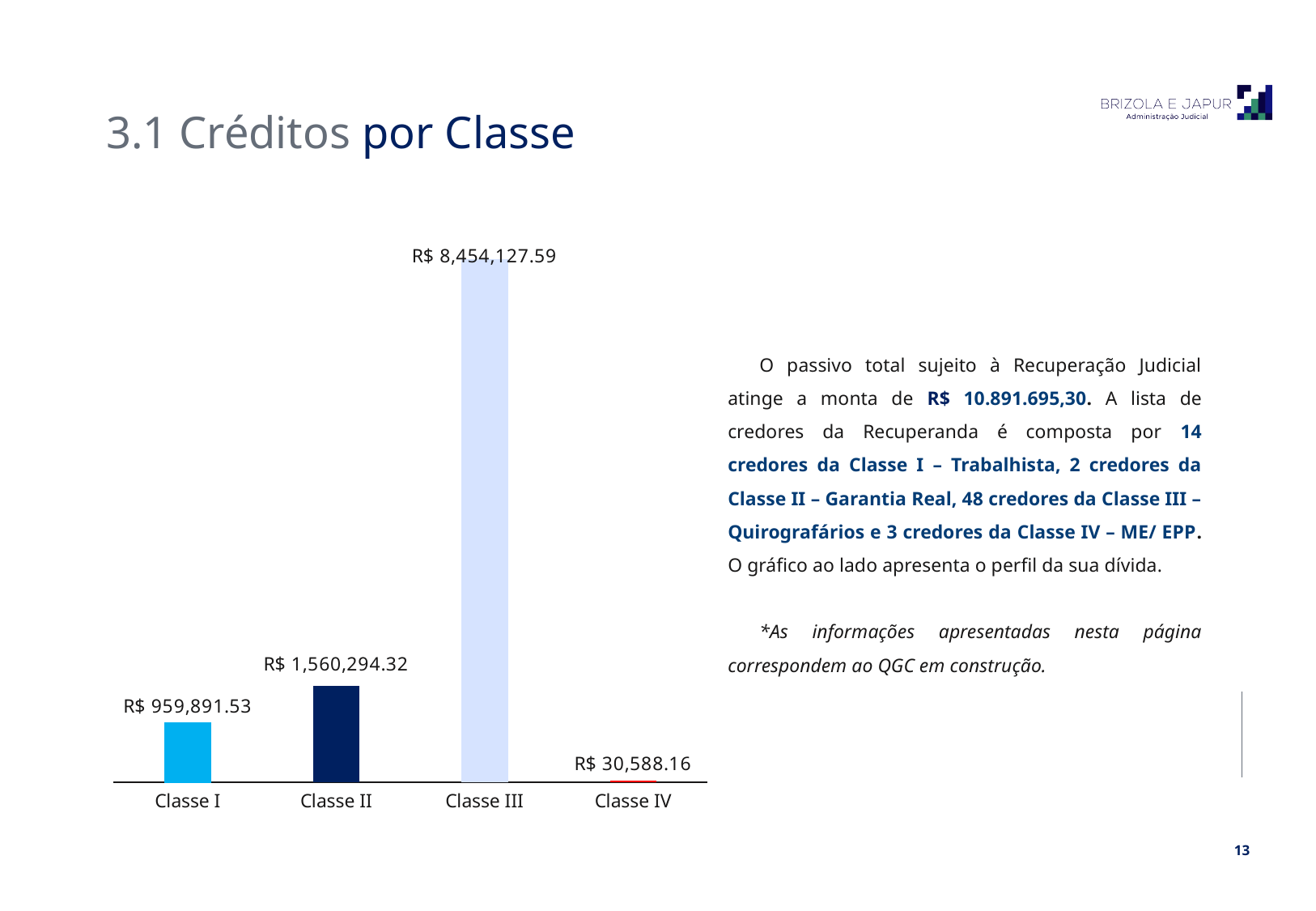
What is the value shown for Classe III? R$ 8,454,127.59 What is the difference between the values for Classe II and Classe I? R$ 600,402.79 Which class has the lowest value? Classe IV How many classes are shown on the x axis of the chart? 4 What is the value shown for Classe I? R$ 959,891.53 What is the value shown for Classe II? R$ 1,560,294.32 What colour is the bar for Classe IV? Red What kind of chart is shown on the slide? Bar chart What is the difference between the values for Classe III and Classe II? R$ 6,893,833.27 Which class has the highest value? Classe III What is the value shown for Classe IV? R$ 30,588.16 Which is larger, the value for Classe I or the value for Classe II? Classe II